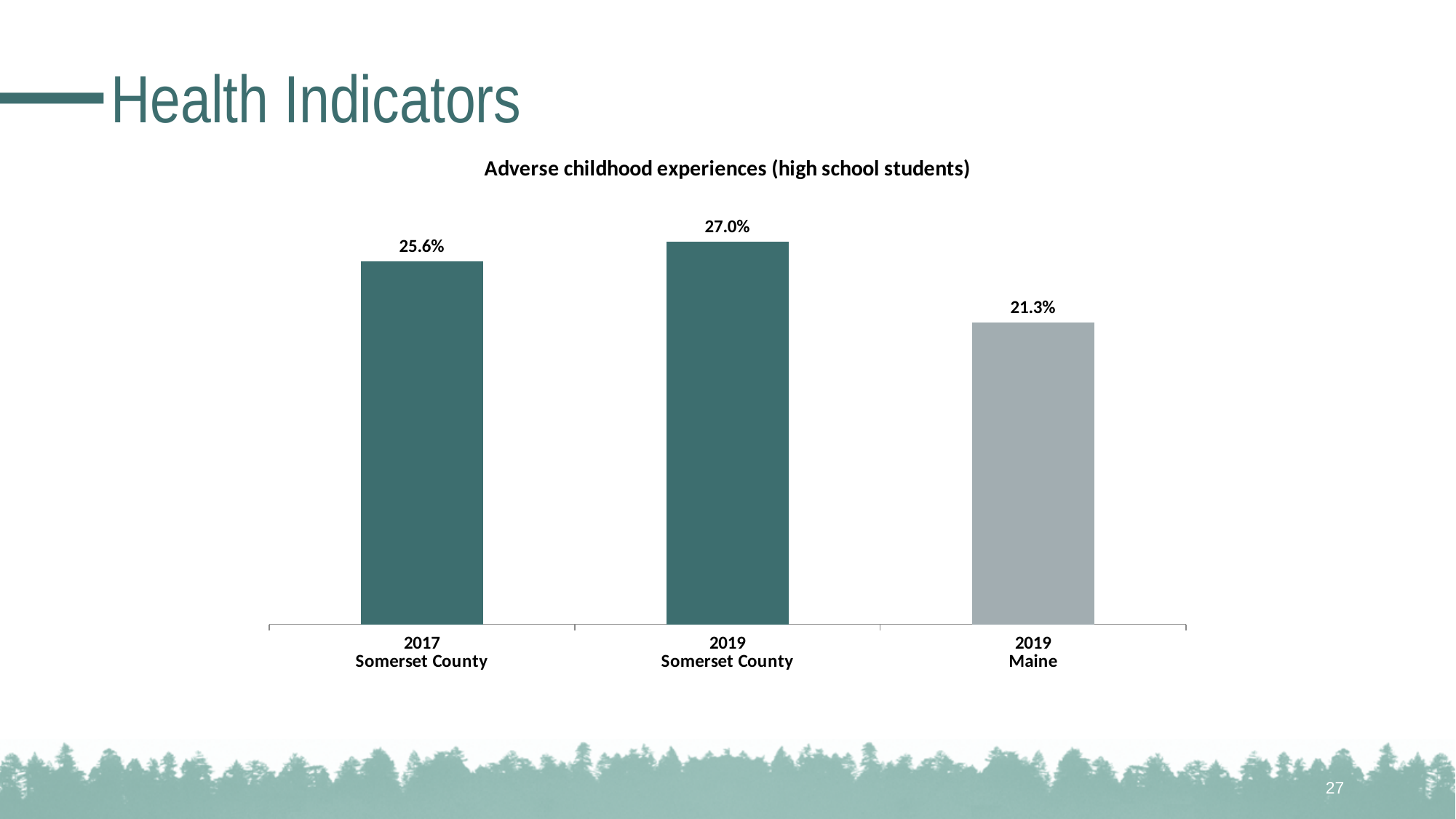
What kind of chart is shown on the slide? Bar chart Which is larger, the value for 2017 Somerset County or the value for 2019 Maine? 2017 Somerset County What is the value for 2019 Somerset County? 27.0% What is the difference between the 2019 Somerset County value and the 2017 Somerset County value? 1.4% How many bars are shown in the chart? 3 What is the title of the chart? Adverse childhood experiences (high school students) What is the difference between the 2019 Somerset County value and the 2019 Maine value? 5.7% Which category has the highest value? 2019 Somerset County What is the value for 2017 Somerset County? 25.6% What is the value for 2019 Maine? 21.3% Which bar is coloured grey rather than teal? 2019 Maine Which category has the lowest value? 2019 Maine